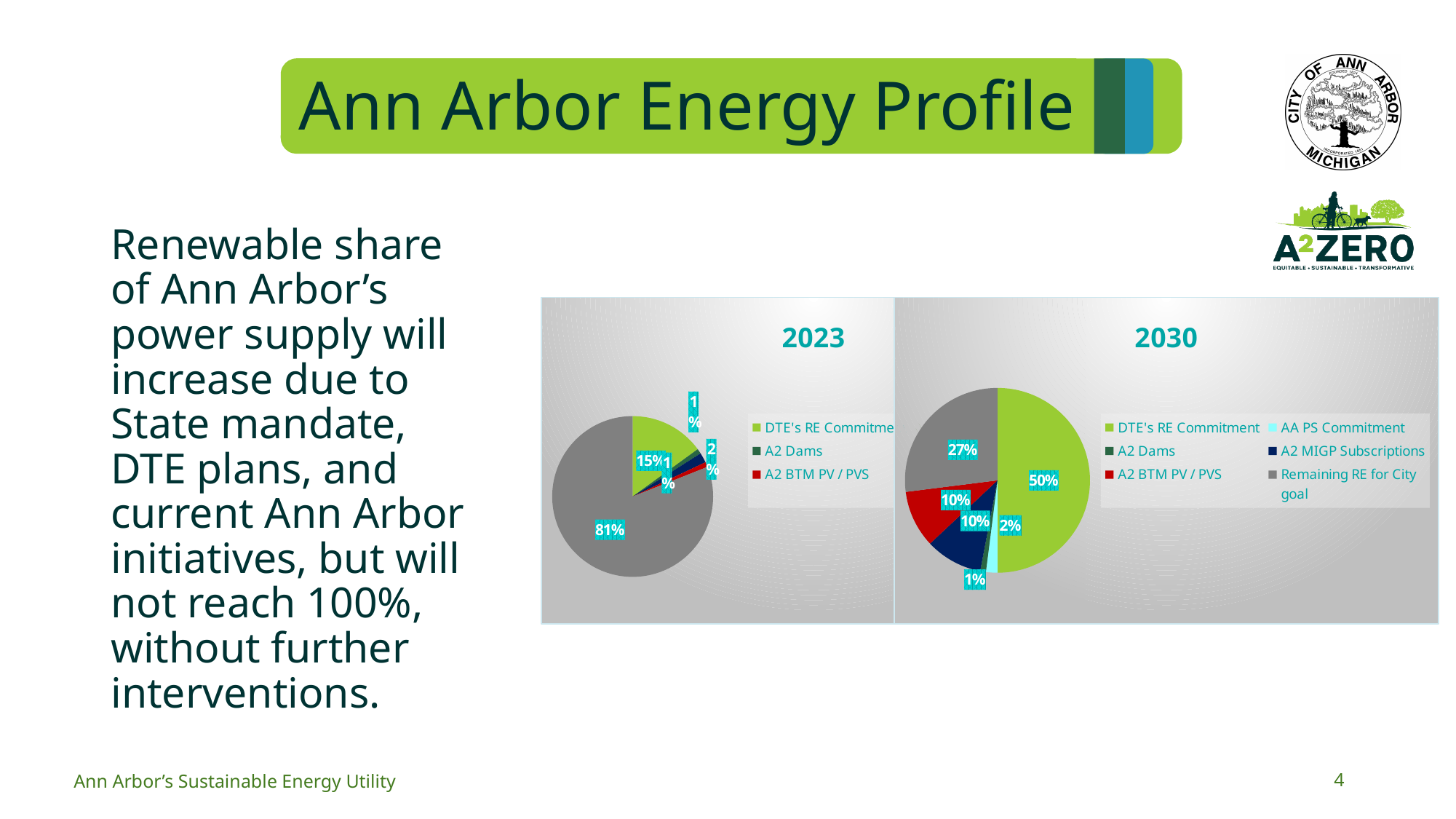
In the 2030 pie chart, what share is labelled for A2 BTM PV / PVS? 10% How many entries does the legend of the 2030 pie chart list? 6 In the 2030 pie chart, what share is labelled for A2 Dams? 1% In the 2030 pie chart, what share is labelled for A2 MIGP Subscriptions? 10% In the 2023 pie chart, what share is labelled for DTE's RE Commitment? 15% In the 2023 pie chart, what is the value of the largest slice? 81% In the 2030 pie chart, what share is labelled for Remaining RE for City goal? 27% In the 2030 pie chart, what share is labelled for AA PS Commitment? 2% In the 2030 pie chart, what share is labelled for DTE's RE Commitment? 50% What type of charts are shown on the slide? Pie charts By how many percentage points does DTE's RE Commitment in the 2030 chart exceed DTE's RE Commitment in the 2023 chart? 35 percentage points In the 2030 pie chart, which category has the largest slice? DTE's RE Commitment